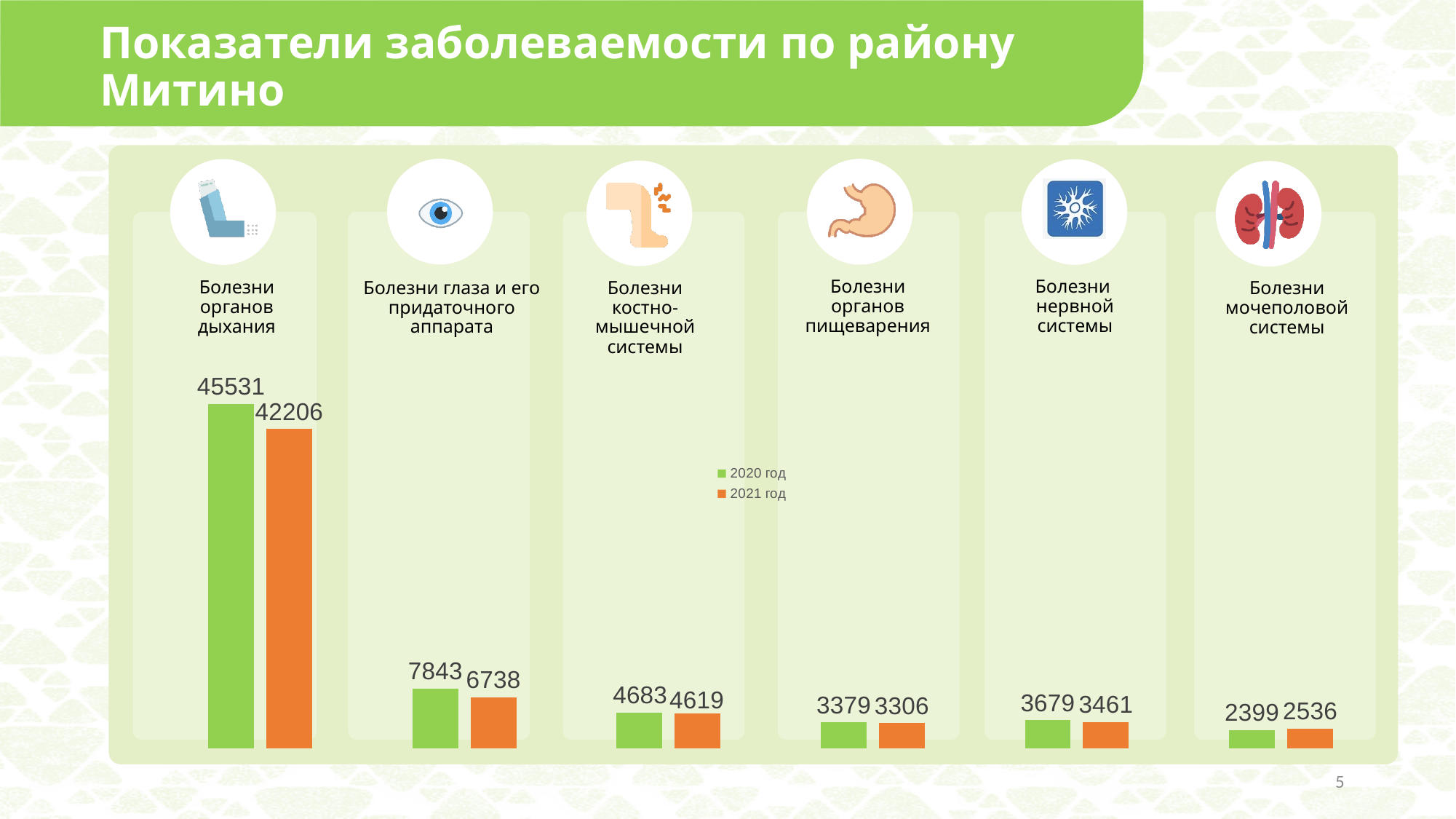
Which category has the highest 2020 год value? Болезни органов дыхания Which category has the lowest 2021 год value? Болезни мочеполовой системы For Болезни мочеполовой системы, which is larger: the 2020 год value or the 2021 год value? 2021 год What is the 2021 год value for Болезни глаза и его придаточного аппарата? 6738 What is the 2020 год value for Болезни нервной системы? 3679 What is the 2020 год value for Болезни органов дыхания? 45531 What is the difference between the 2020 год and 2021 год values for Болезни органов дыхания? 3325 How many series does the legend list? 2 What is the 2021 год value for Болезни мочеполовой системы? 2536 What is the difference between the 2020 год and 2021 год values for Болезни костно-мышечной системы? 64 What type of chart is shown on the slide? Bar chart How many disease categories are shown in the chart? 6